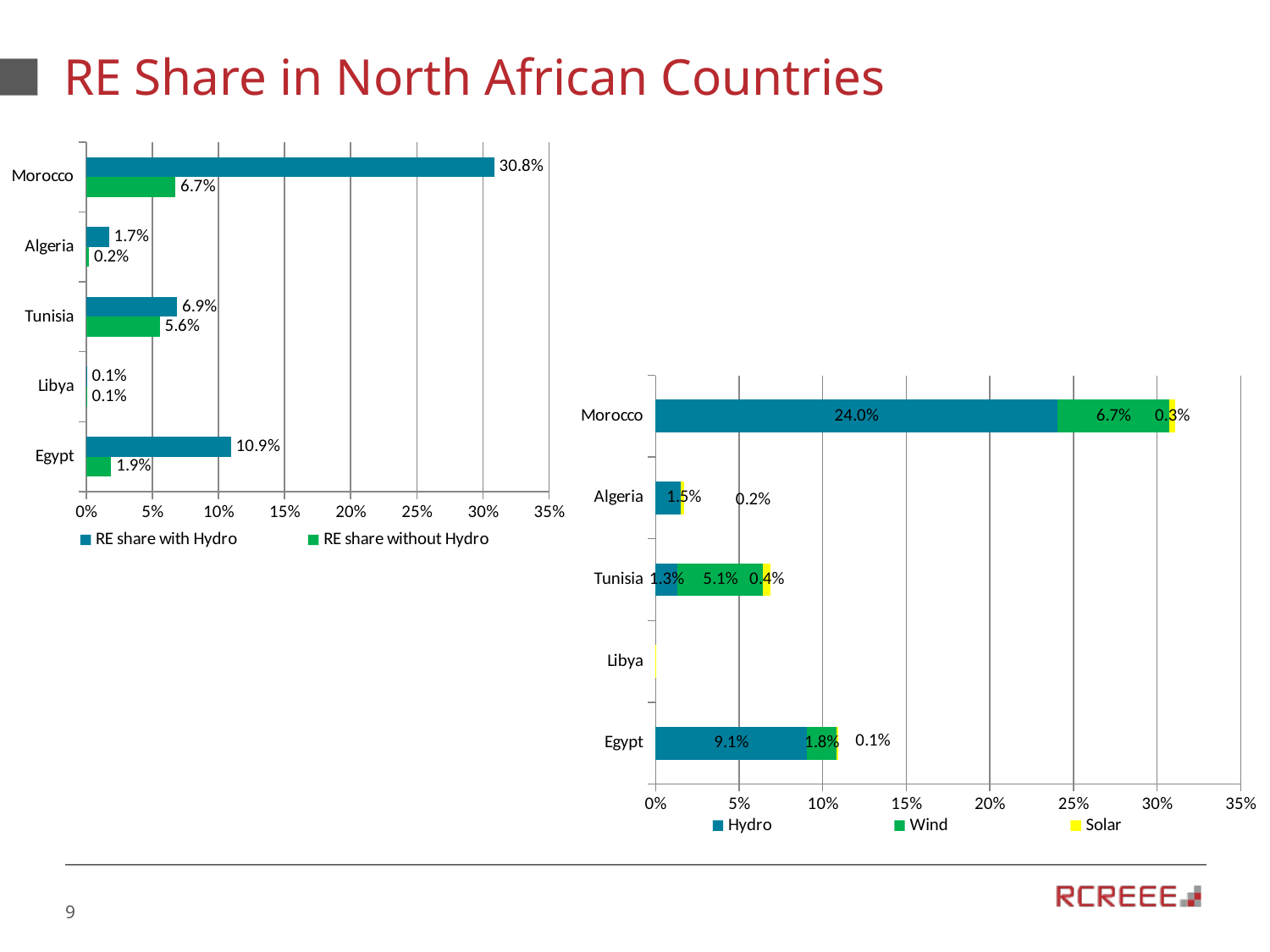
In the chart on the right, what is the total stacked value for Egypt? 11.0% In the chart on the left, what is the difference between Egypt's RE share with Hydro and without Hydro? 9.0% In the chart on the left, which country has the highest RE share with Hydro? Morocco In the chart on the left, what is the RE share without Hydro for Tunisia? 5.6% In the chart on the right, what is the Hydro share for Morocco? 24.0% What type of chart is the chart on the right? Stacked bar chart In the chart on the right, how many series does the legend list? 3 In the chart on the left, which country has the lowest RE share with Hydro? Libya In the chart on the right, what is the Wind share for Tunisia? 5.1% In the chart on the left, how many series does the legend list? 2 In the chart on the right, is Egypt's Hydro share larger than Tunisia's Hydro share? Yes In the chart on the left, what is the RE share with Hydro for Morocco? 30.8%